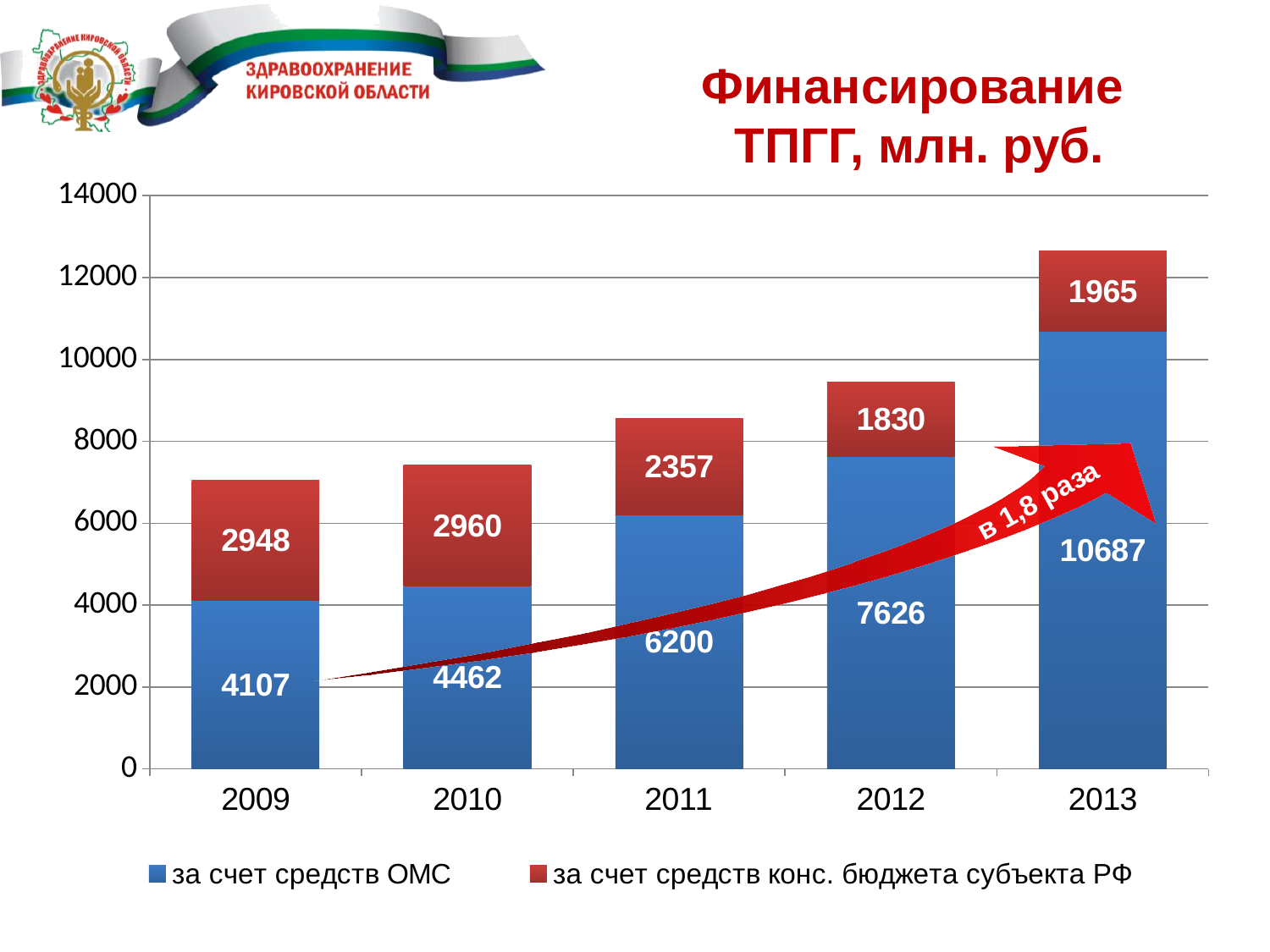
What kind of chart is shown on the slide? Stacked bar chart What is the value for 'за счет средств конс. бюджета субъекта РФ' in 2011? 2357 What is the value for 'за счет средств ОМС' in 2013? 10687 What is the difference between the 'за счет средств ОМС' values for 2013 and 2012? 3061 Which year has the lowest value for 'за счет средств конс. бюджета субъекта РФ'? 2012 What is the total of the stacked bar for 2013? 12652 How many series does the legend list? 2 What is the total of the stacked bar for 2009? 7055 Which year has the highest value for 'за счет средств ОМС'? 2013 Which is larger: the 'за счет средств конс. бюджета субъекта РФ' value in 2010 or in 2013? 2010 How many years are shown on the x axis? 5 What is the value for 'за счет средств ОМС' in 2009? 4107